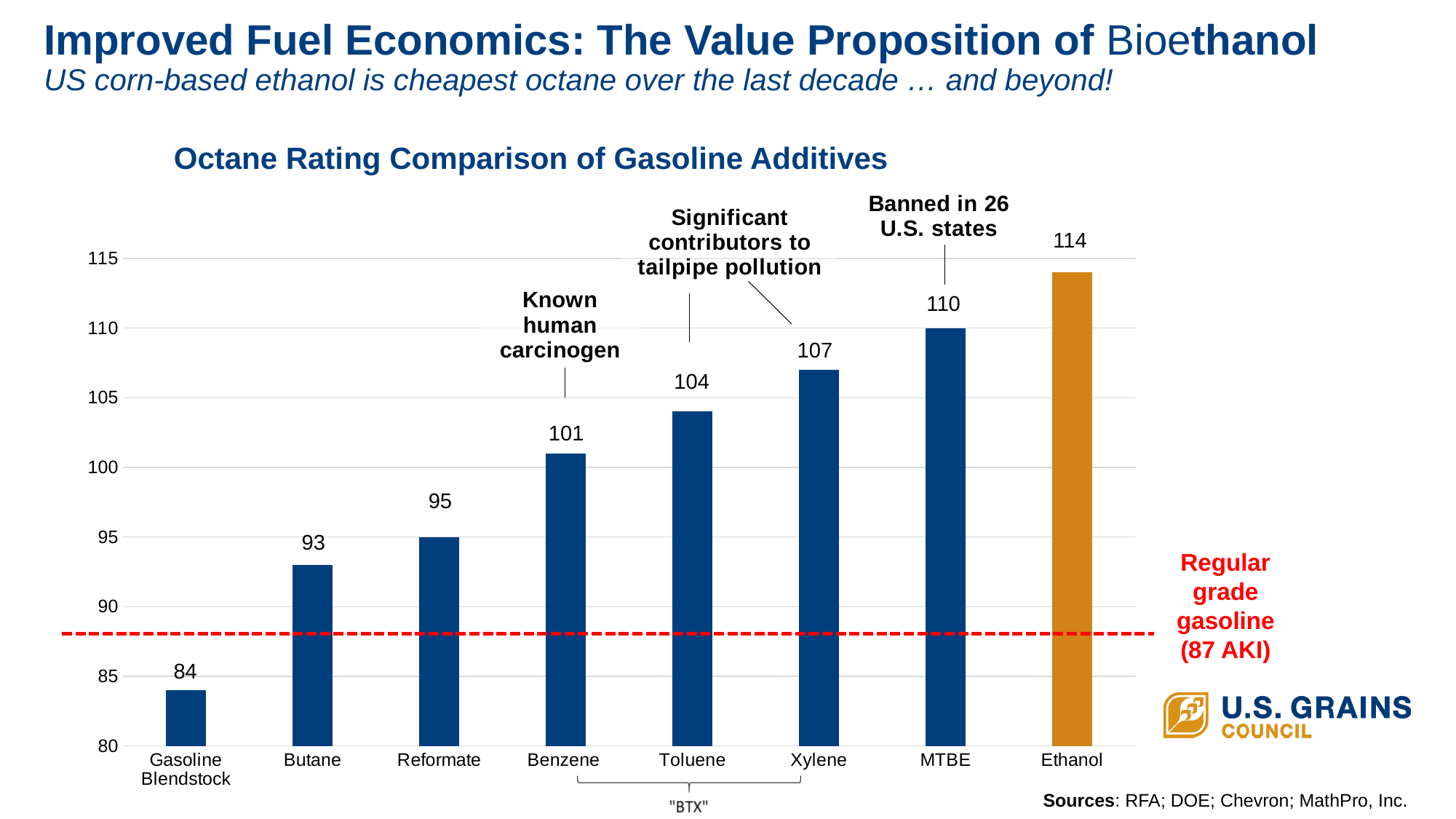
Which has a higher octane rating, Reformate or Benzene? Benzene Do the octane ratings rise or fall from left to right across the x axis? Rise Which additive has the highest octane rating? Ethanol What is the difference between the octane ratings of Xylene and Butane? 14 What is the difference between the octane ratings of Ethanol and MTBE? 4 How many additives are plotted in the chart? 8 Is the value for MTBE greater or less than 105? greater What kind of chart is shown on the slide? Bar chart What is the octane rating shown for Ethanol? 114 What is the octane rating shown for Gasoline Blendstock? 84 Which category has the lowest octane rating? Gasoline Blendstock What is the octane rating shown for Toluene? 104